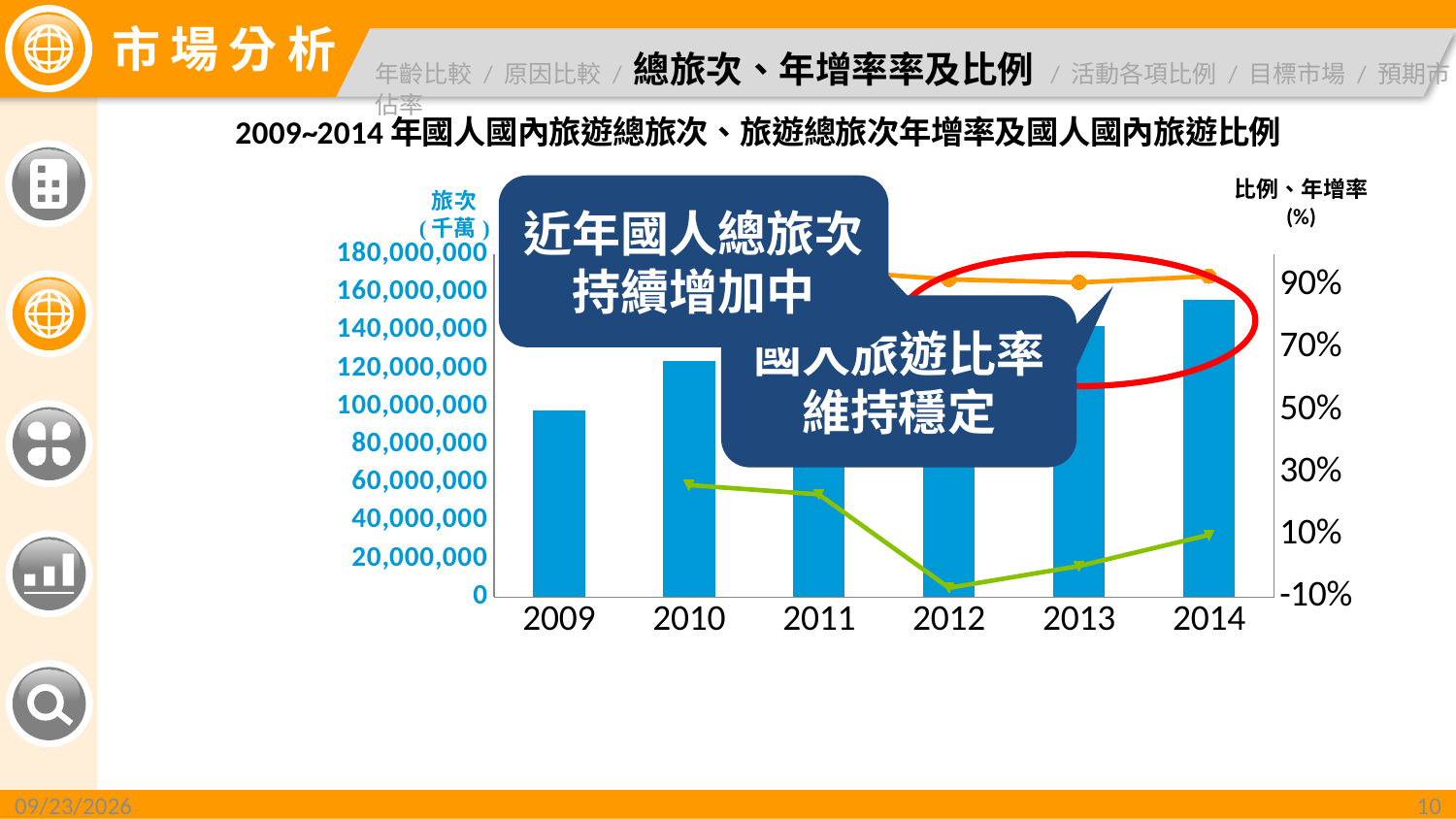
What is the label of the right-hand vertical axis? 比例、年增率(%) Is the green line value for 2010 greater or less than 10%? greater How many years are shown on the x axis? 6 Does the green line rise or fall from 2012 to 2014? rise Which year has the taller total trips bar, 2009 or 2014? 2014 What kind of chart is used to show the total trips (旅次) by year? bar chart Which year has the taller total trips bar, 2009 or 2010? 2010 Is the green line value for 2012 greater or less than 10%? less Is the total trips bar for 2013 greater or less than 120,000,000? greater